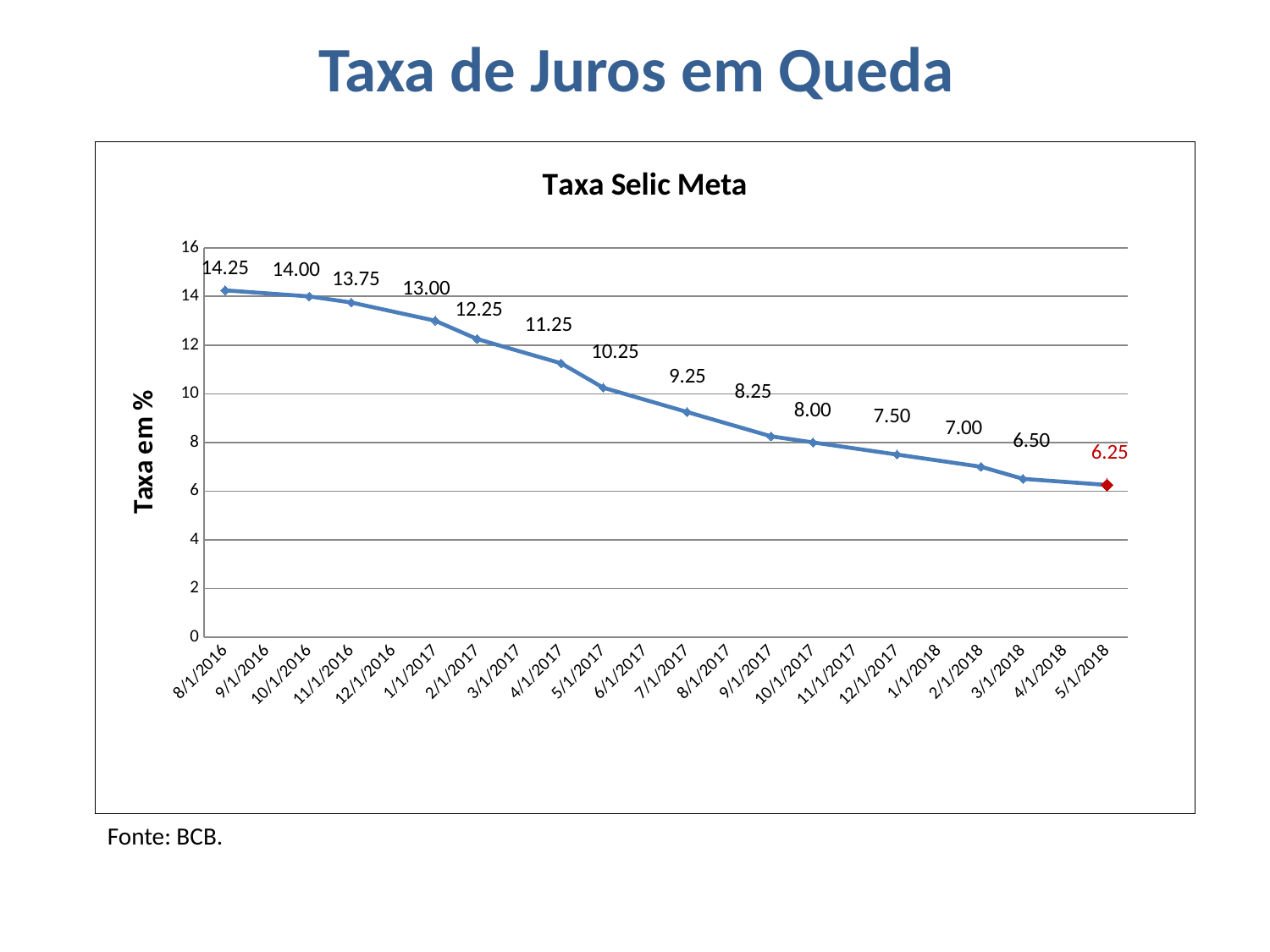
What type of chart is shown on the slide? line chart What is the value of the Taxa Selic Meta at 8/1/2016? 14.25 At which date is the Taxa Selic Meta highest? 8/1/2016 At which date is the Taxa Selic Meta lowest? 5/1/2018 What is the label of the vertical axis? Taxa em % What is the value of the Taxa Selic Meta at 4/1/2017? 11.25 What is the value of the Taxa Selic Meta at 10/1/2017? 8.00 Which is larger, the Taxa Selic Meta at 2/1/2017 or at 7/1/2017? 2/1/2017 What is the value of the Taxa Selic Meta at 5/1/2018? 6.25 Do the values of the Taxa Selic Meta rise or fall along the x axis? fall What is the difference between the Taxa Selic Meta at 8/1/2016 and at 5/1/2018? 8.00 What is the title of the chart? Taxa Selic Meta